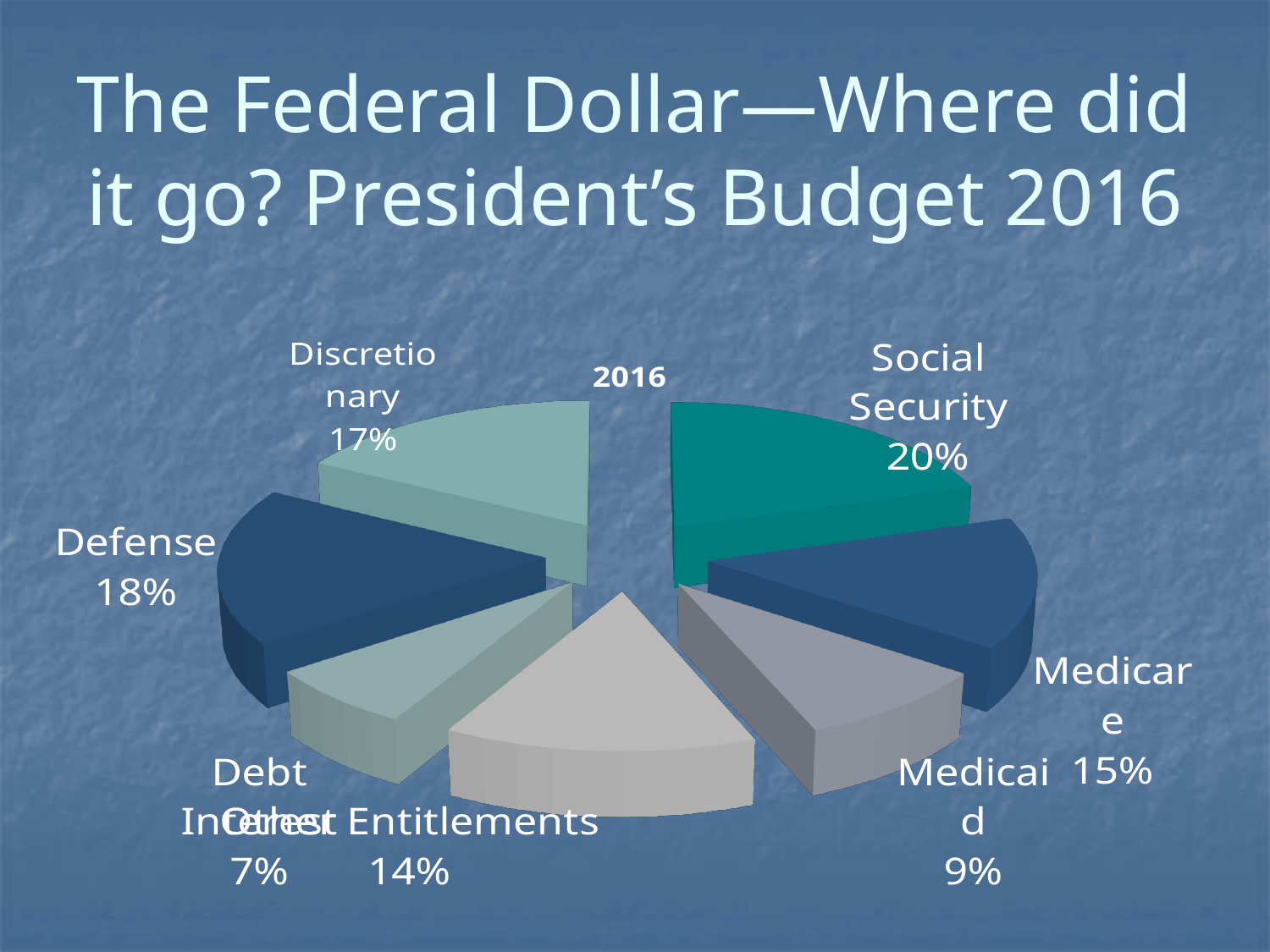
What share of the federal dollar goes to Social Security? 20% How many slices does the pie chart have? 7 Which is larger, the slice for Medicare or the slice for Other Entitlements? Medicare What is the title printed above the pie chart? 2016 What kind of chart is shown on the slide? pie chart What percentage is shown for Medicare? 15% Which category has the largest slice of the pie? Social Security What percentage is shown for Discretionary? 17% Which category has the smallest slice of the pie? Debt Interest What percentage is shown for Defense? 18% What is the difference in percentage points between Social Security and Defense? 2% What percentage is shown for Medicaid? 9%